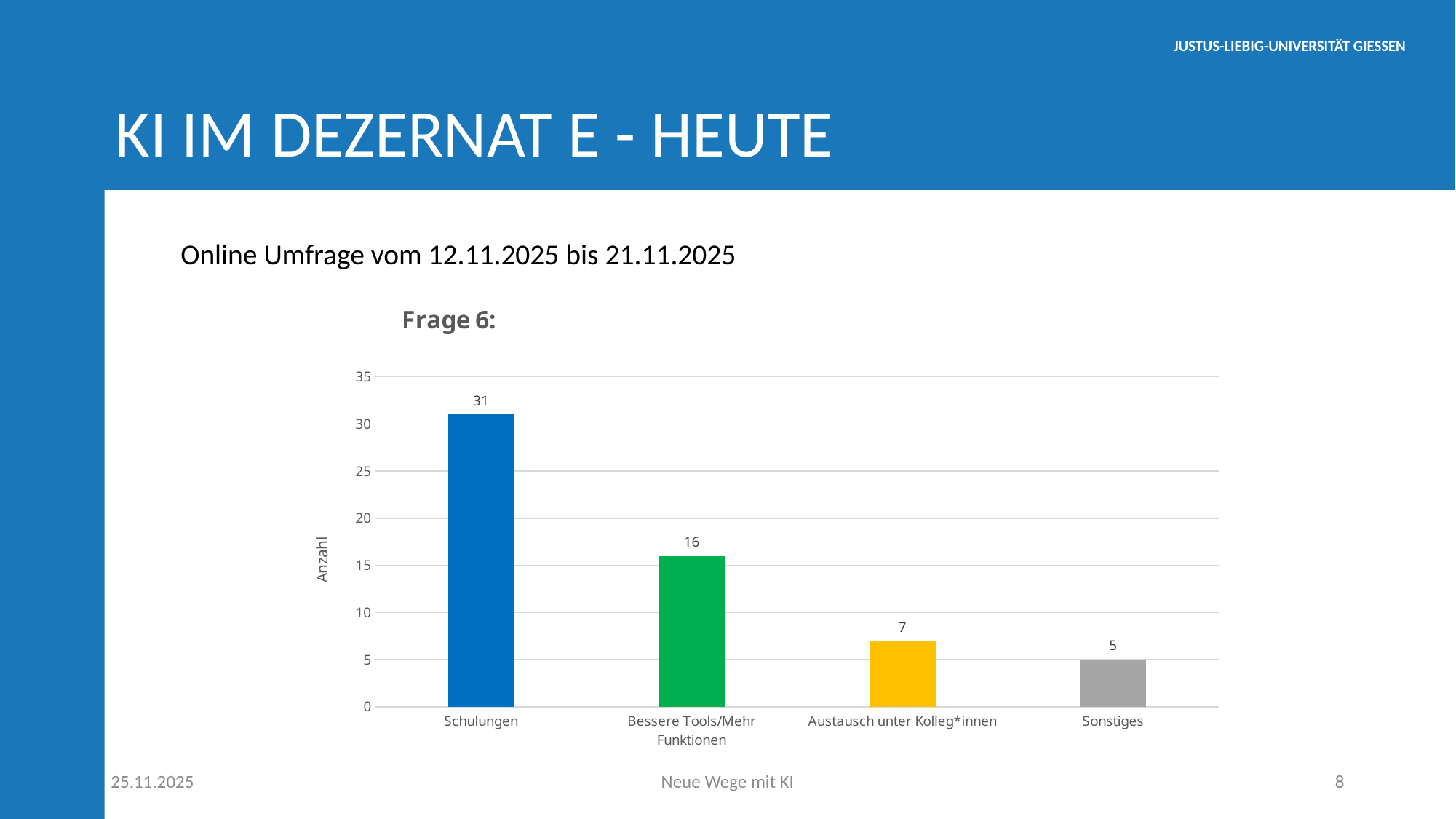
Is the value for Bessere Tools/Mehr Funktionen greater or less than 20? less Which category has the lowest value? Sonstiges How many categories are shown in the chart? 4 Which category has the highest value? Schulungen What is the value for Schulungen? 31 What is the value for Austausch unter Kolleg*innen? 7 What kind of chart is shown on the slide? bar chart What is the title of the chart? Frage 6: What is the value for Bessere Tools/Mehr Funktionen? 16 What is the value for Sonstiges? 5 What is the difference between the values for Schulungen and Bessere Tools/Mehr Funktionen? 15 Which is larger, the value for Austausch unter Kolleg*innen or the value for Sonstiges? Austausch unter Kolleg*innen